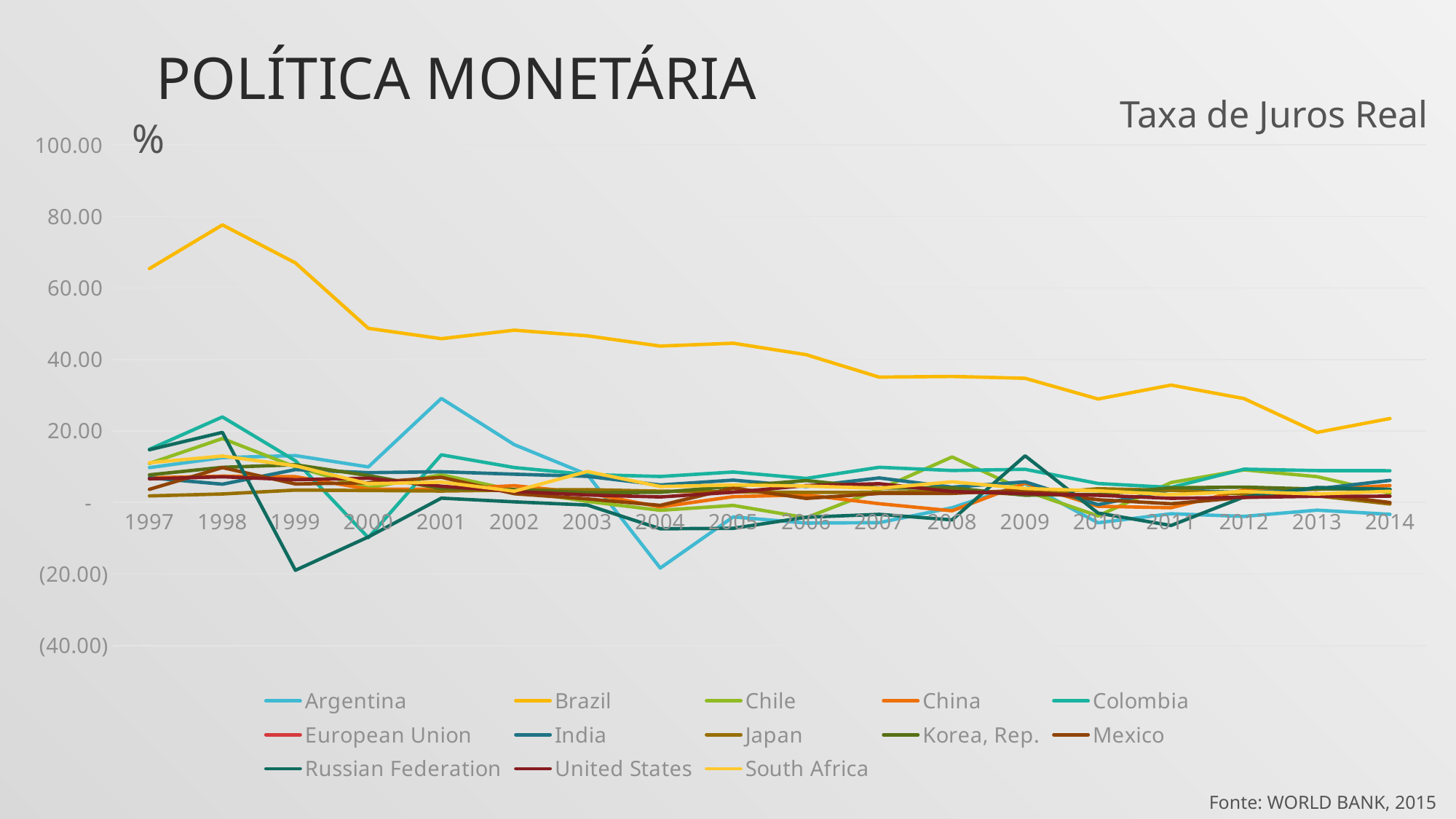
Is the value for Brazil in 2007 greater or less than 40.00? less Is the value for Brazil in 2000 greater or less than 40.00? greater Is the value for Argentina in 2001 greater or less than 20.00? greater What source is cited for the chart data? WORLD BANK, 2015 Does the Brazil line generally rise or fall from 1997 to 2014? fall What is the title of the chart? Taxa de Juros Real How many years are plotted along the x axis? 18 How many series does the legend list? 13 In 2001, which is larger, the value for Brazil or the value for Argentina? Brazil What kind of chart is shown on the slide? line chart Which series has the highest values across the whole period? Brazil